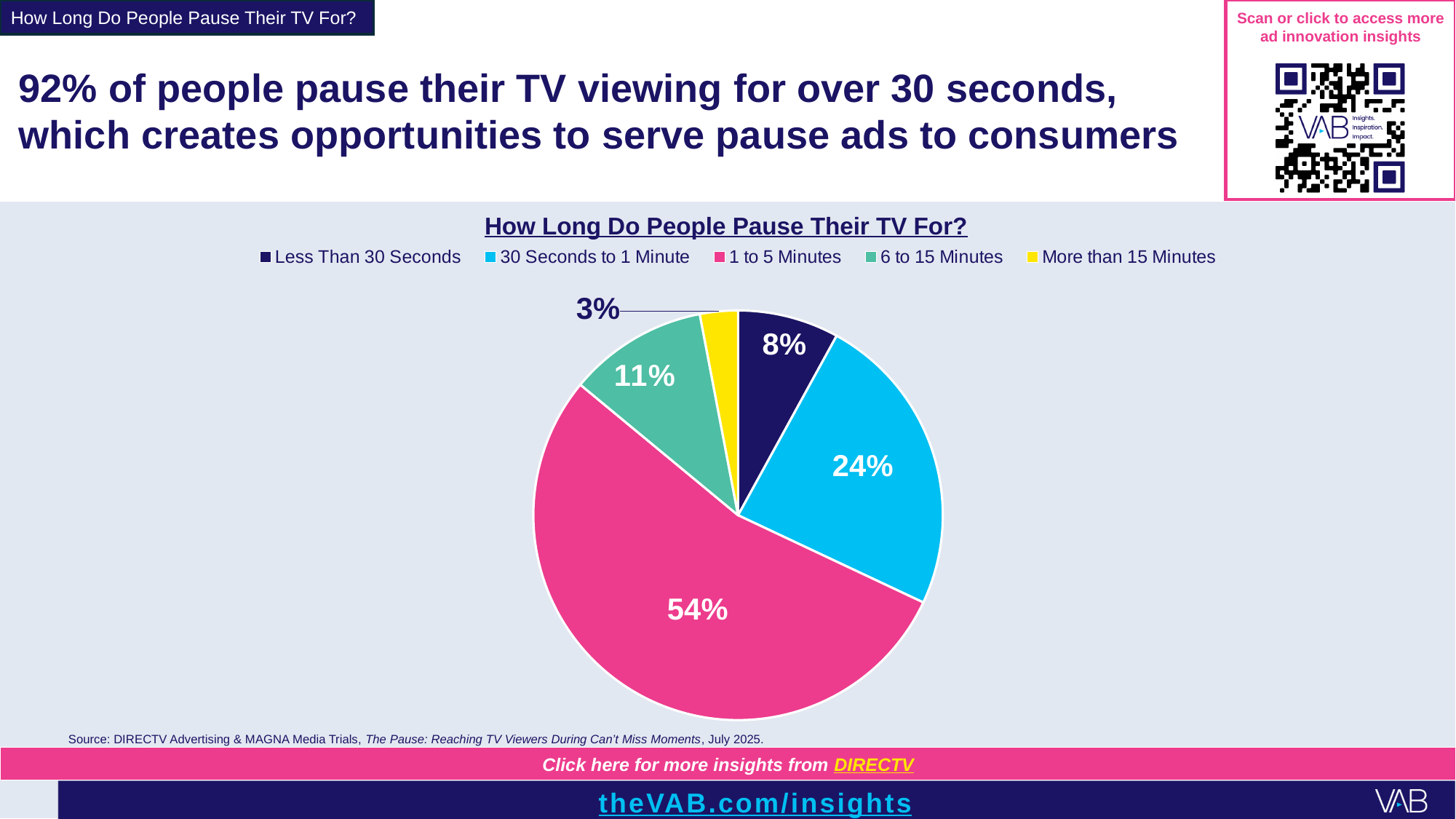
How many categories does the legend list? 5 What is the title of the chart? How Long Do People Pause Their TV For? What type of chart is shown on the slide? Pie chart What share of people pause their TV for 6 to 15 minutes? 11% What is the difference between the share for 1 to 5 minutes and the share for 30 seconds to 1 minute? 30% What share of people pause their TV for 1 to 5 minutes? 54% What share of people pause their TV for 30 seconds to 1 minute? 24% What share of people pause their TV for more than 15 minutes? 3% What share of people pause their TV for less than 30 seconds? 8% Which is larger: the share for 6 to 15 minutes or the share for less than 30 seconds? 6 to 15 Minutes Which pause duration category has the smallest share? More than 15 Minutes Which pause duration category has the largest share? 1 to 5 Minutes